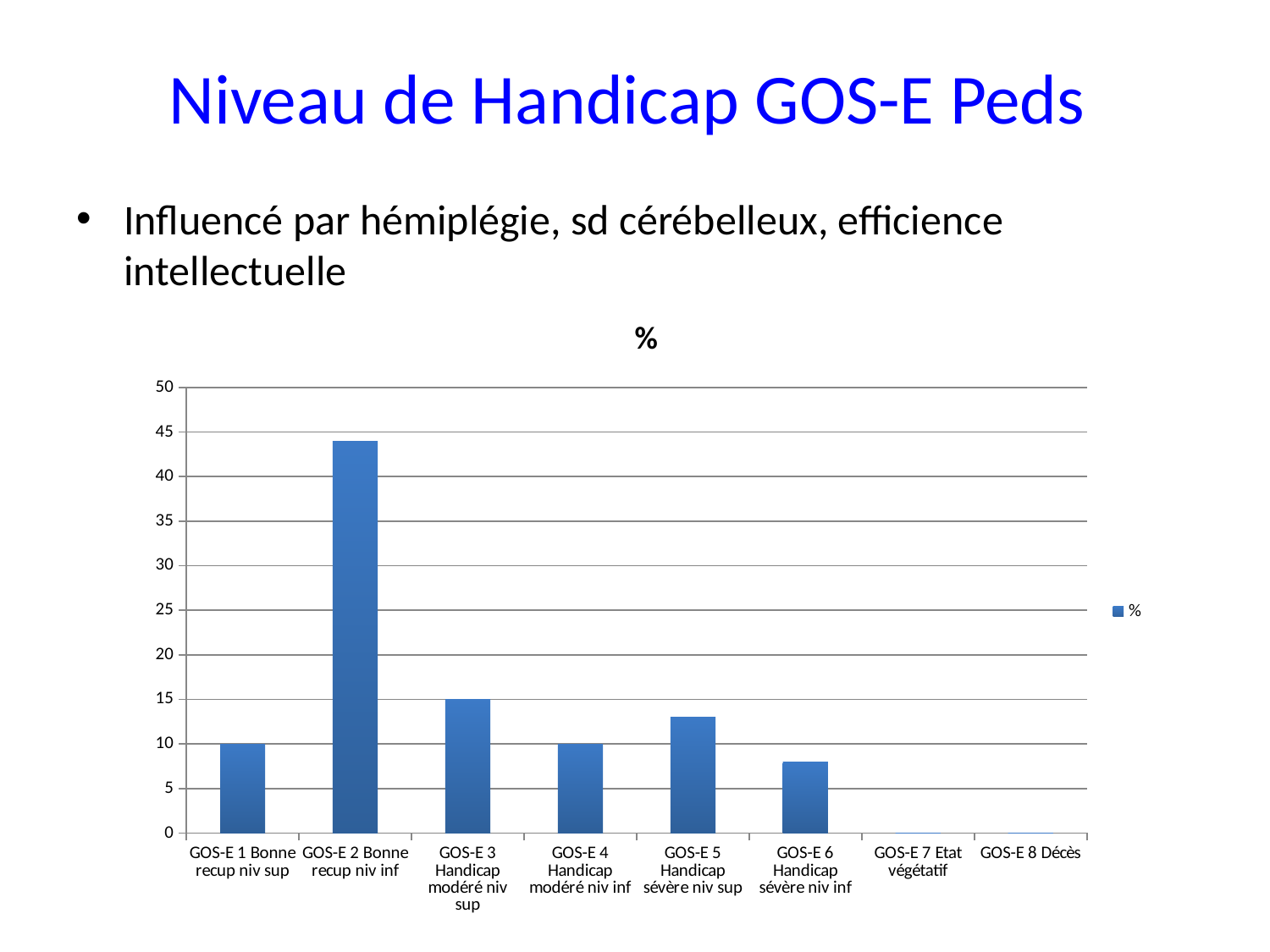
Which is larger, the value for GOS-E 2 Bonne recup niv inf or GOS-E 3 Handicap modéré niv sup? GOS-E 2 Bonne recup niv inf Is the value for GOS-E 2 Bonne recup niv inf greater or less than 40? greater What is the value for GOS-E 1 Bonne recup niv sup? 10 Which category has the highest value in the chart? GOS-E 2 Bonne recup niv inf What is the value for GOS-E 7 Etat végétatif? 0 What is the value for GOS-E 3 Handicap modéré niv sup? 15 What is the title of the chart? % What is the difference between the values for GOS-E 3 Handicap modéré niv sup and GOS-E 1 Bonne recup niv sup? 5 Is the value for GOS-E 6 Handicap sévère niv inf greater or less than 10? less How many series does the chart legend list? 1 What type of chart is shown on the slide? bar chart How many categories are shown on the x axis of the chart? 8